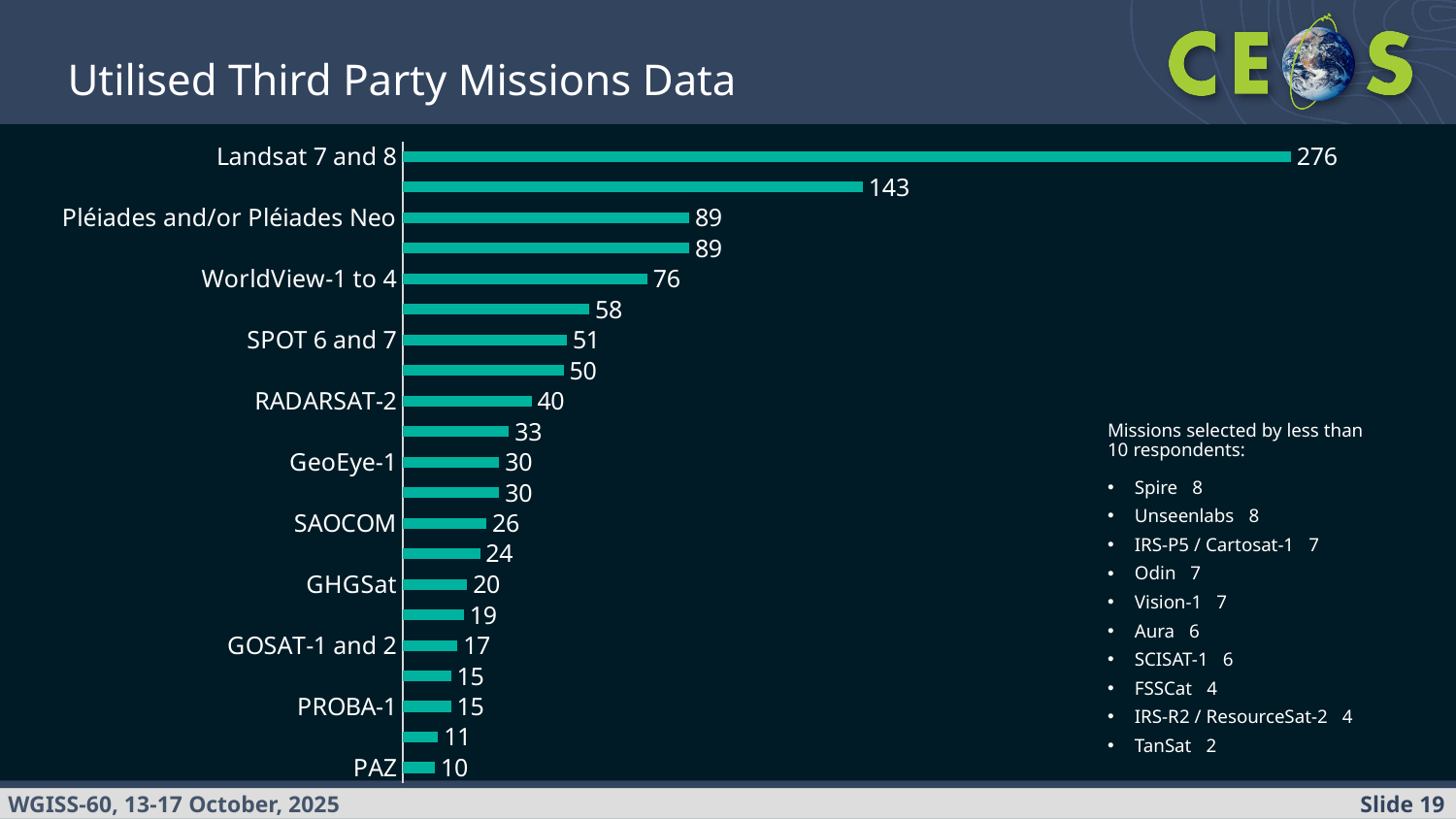
What is the value for GHGSat? 20 How many bars are plotted in the chart? 21 What kind of chart is shown on the slide? bar chart What is the value for RADARSAT-2? 40 Which labelled mission has the lowest value? PAZ Which has a larger value, SPOT 6 and 7 or GeoEye-1? SPOT 6 and 7 What is the value for WorldView-1 to 4? 76 What is the value for Landsat 7 and 8? 276 Which labelled mission has the highest value? Landsat 7 and 8 What is the difference between the values for Landsat 7 and 8 and Pléiades and/or Pléiades Neo? 187 What is the title of the slide's chart? Utilised Third Party Missions Data Do the bar values rise or fall going from the top of the chart to the bottom? fall